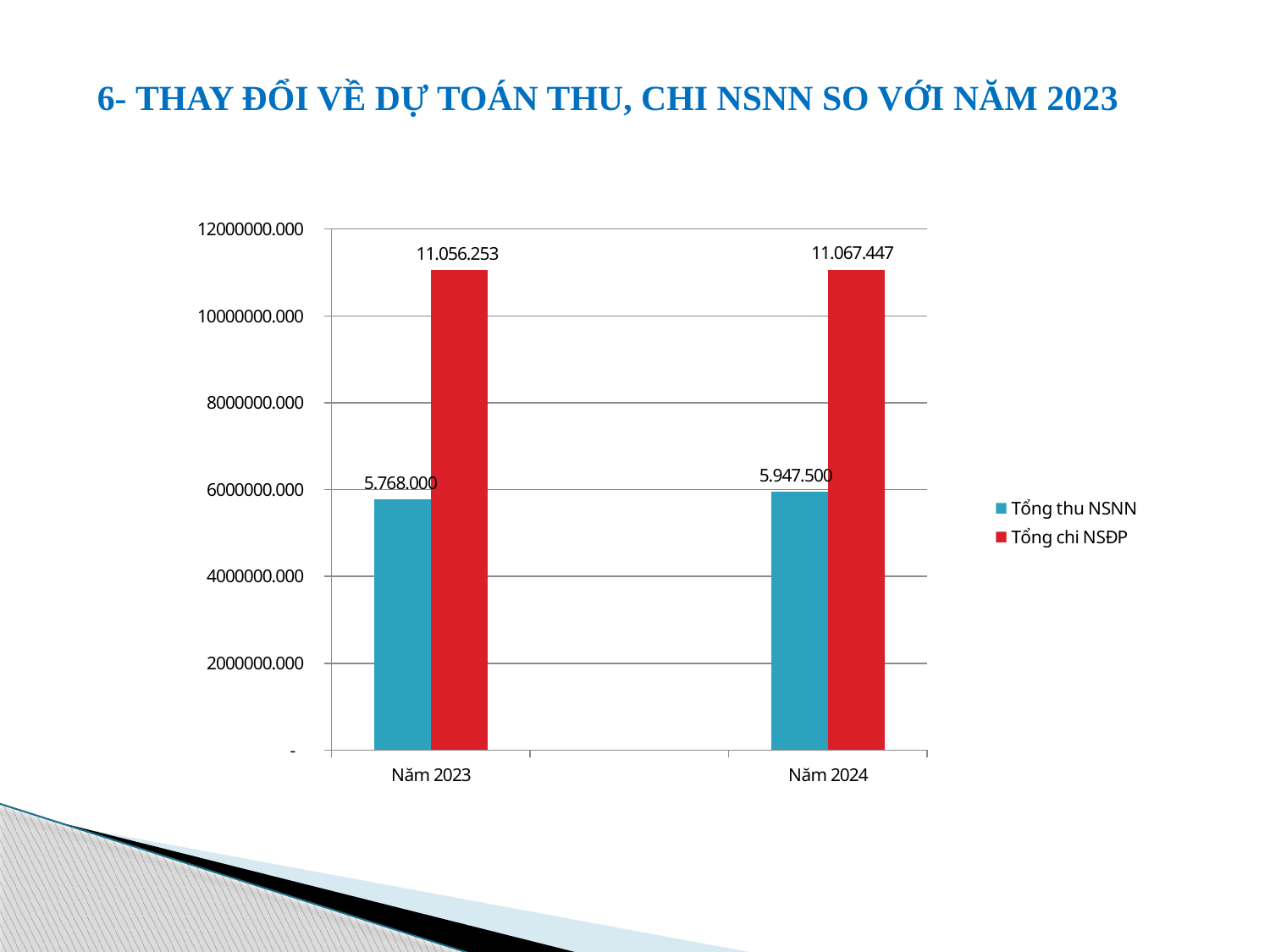
What is the value of Tổng thu NSNN for Năm 2023? 5.768.000 How many categories are shown on the x axis of the chart? 2 How many series does the legend list? 2 What type of chart is shown on the slide? Bar chart What is the value of Tổng chi NSĐP for Năm 2024? 11.067.447 Is the value of Tổng chi NSĐP for Năm 2024 greater or less than 10000000.000? greater What is the difference between Tổng chi NSĐP and Tổng thu NSNN in Năm 2023? 5.288.253 By how much did Tổng thu NSNN increase from Năm 2023 to Năm 2024? 179.500 Is the value of Tổng thu NSNN for Năm 2023 greater or less than 6000000.000? less What is the value of Tổng chi NSĐP for Năm 2023? 11.056.253 Which series has the higher value in Năm 2024, Tổng thu NSNN or Tổng chi NSĐP? Tổng chi NSĐP What is the value of Tổng thu NSNN for Năm 2024? 5.947.500